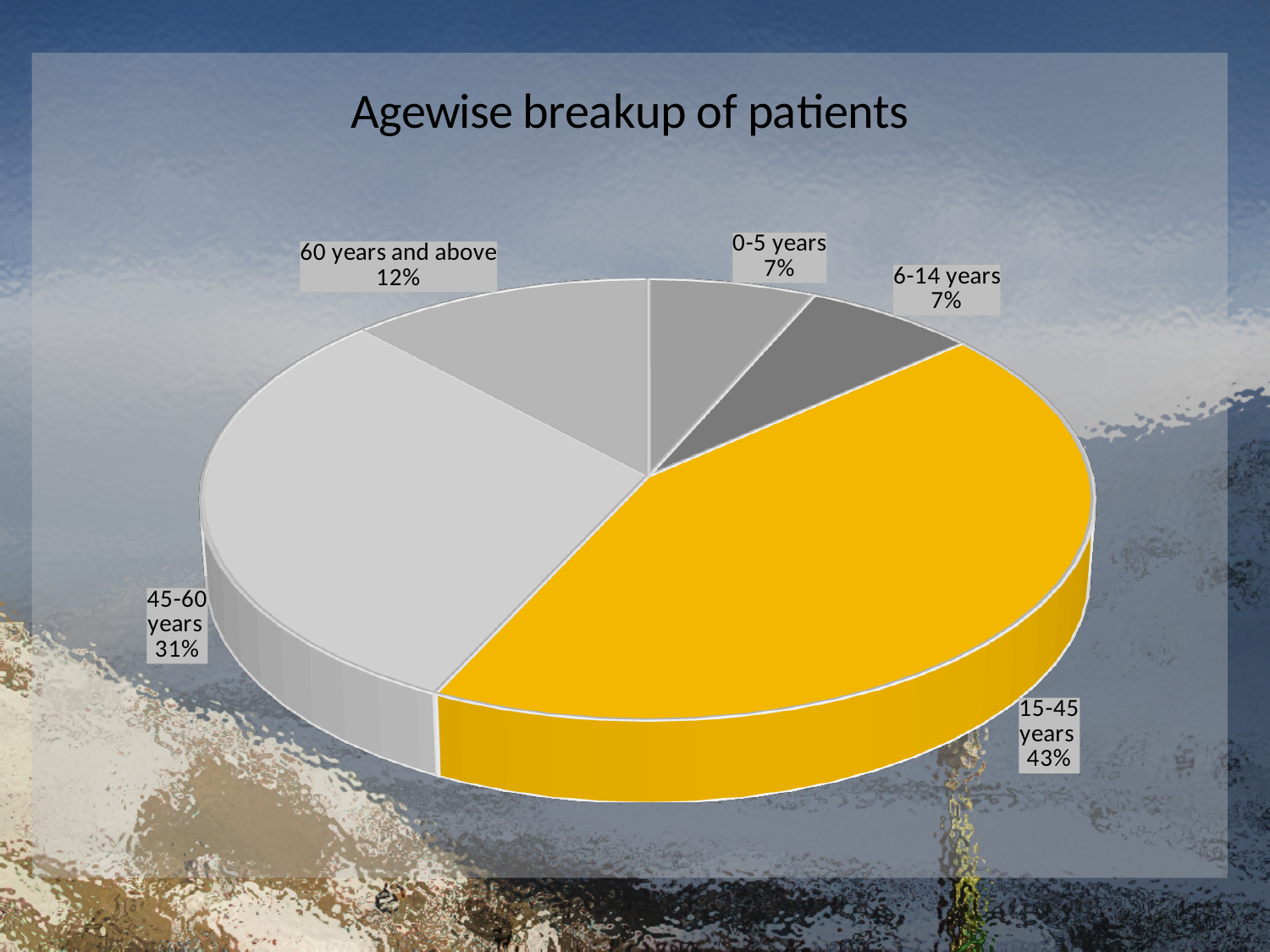
Which age group has the largest share of patients? 15-45 years What share of patients are in the 15-45 years group? 43% What kind of chart is shown on the slide? Pie chart What is the difference in percentage points between the 15-45 years and 45-60 years groups? 12 What is the difference in percentage points between the 45-60 years group and the 60 years and above group? 19 Which slice of the pie is coloured yellow? 15-45 years Which is larger, the share for 60 years and above or the share for 6-14 years? 60 years and above What is the title of the chart? Agewise breakup of patients How many age groups are shown in the pie chart? 5 What share of patients are 60 years and above? 12% What share of patients are in the 45-60 years group? 31% What share of patients are in the 0-5 years group? 7%